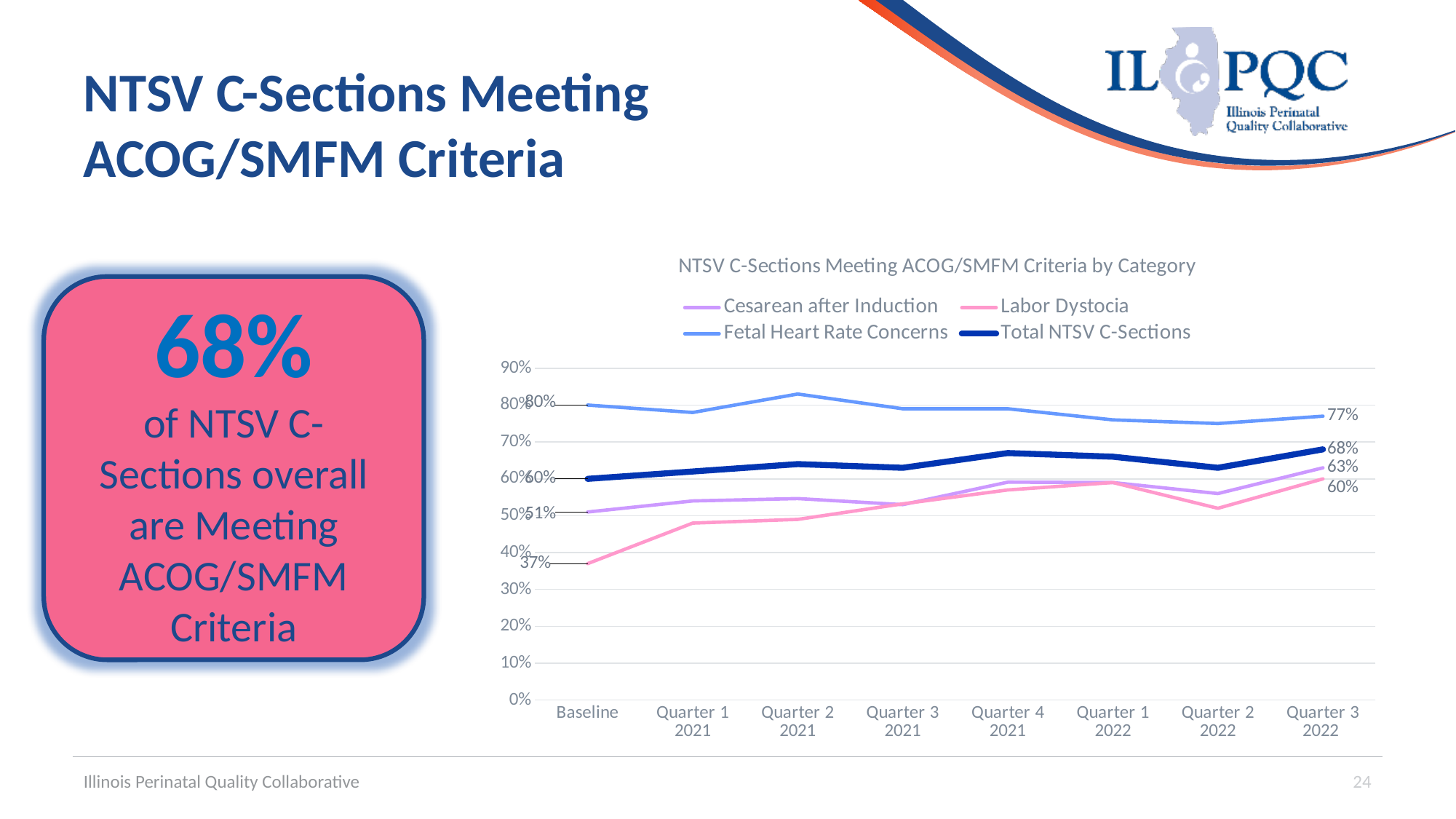
Which series has the highest value in Quarter 3 2022? Fetal Heart Rate Concerns By how many percentage points did Labor Dystocia change from Baseline (37%) to Quarter 3 2022 (60%)? 23 percentage points Which series has the lowest value at Baseline? Labor Dystocia How many series does the chart legend list? 4 Does the Labor Dystocia line generally rise or fall from Baseline to Quarter 3 2022? rise Is the Fetal Heart Rate Concerns value in Quarter 2 2021 greater or less than 80%? greater What kind of chart is shown on the slide? line chart What is the Labor Dystocia value at Baseline? 37% What is the Fetal Heart Rate Concerns value in Quarter 3 2022? 77% What is the Total NTSV C-Sections value in Quarter 3 2022? 68% What is the Total NTSV C-Sections value at Baseline? 60% How many time points are shown along the x axis of the chart? 8